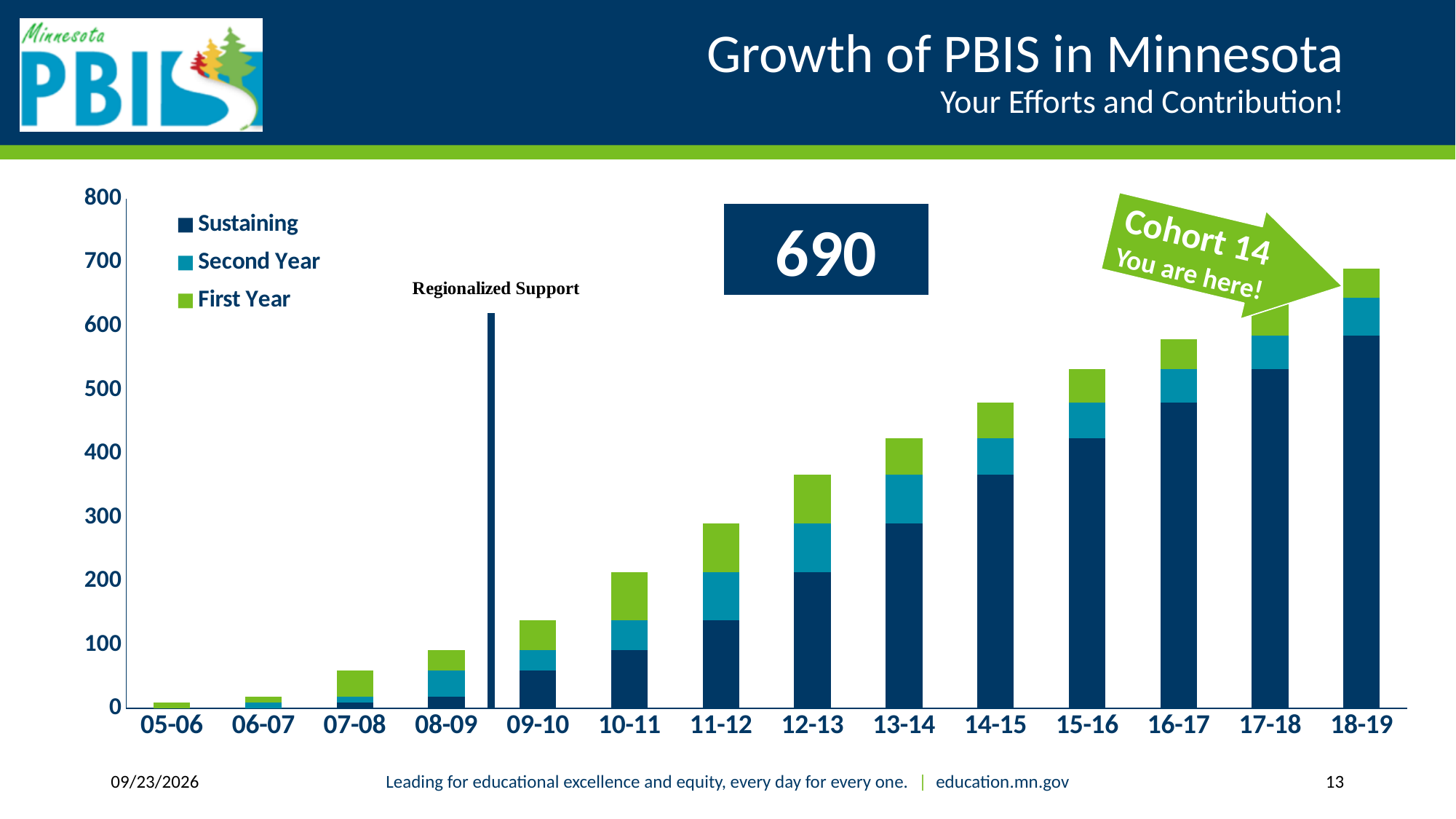
How many series does the chart's legend list? 3 Is the Sustaining value for 14-15 greater or less than 400? less What are the three series named in the chart's legend? Sustaining, Second Year, First Year What kind of chart is shown on the slide? Stacked bar chart Which has the taller stacked bar, 12-13 or 10-11? 12-13 Which school year has the tallest stacked bar in the chart? 18-19 How many school-year categories are shown on the x axis of the chart? 14 Which school year has the shortest stacked bar in the chart? 05-06 Is the total bar height for 09-10 greater or less than 200? less Is the total bar height for 16-17 greater or less than 500? greater Do the total bar heights rise or fall from 05-06 to 18-19? Rise